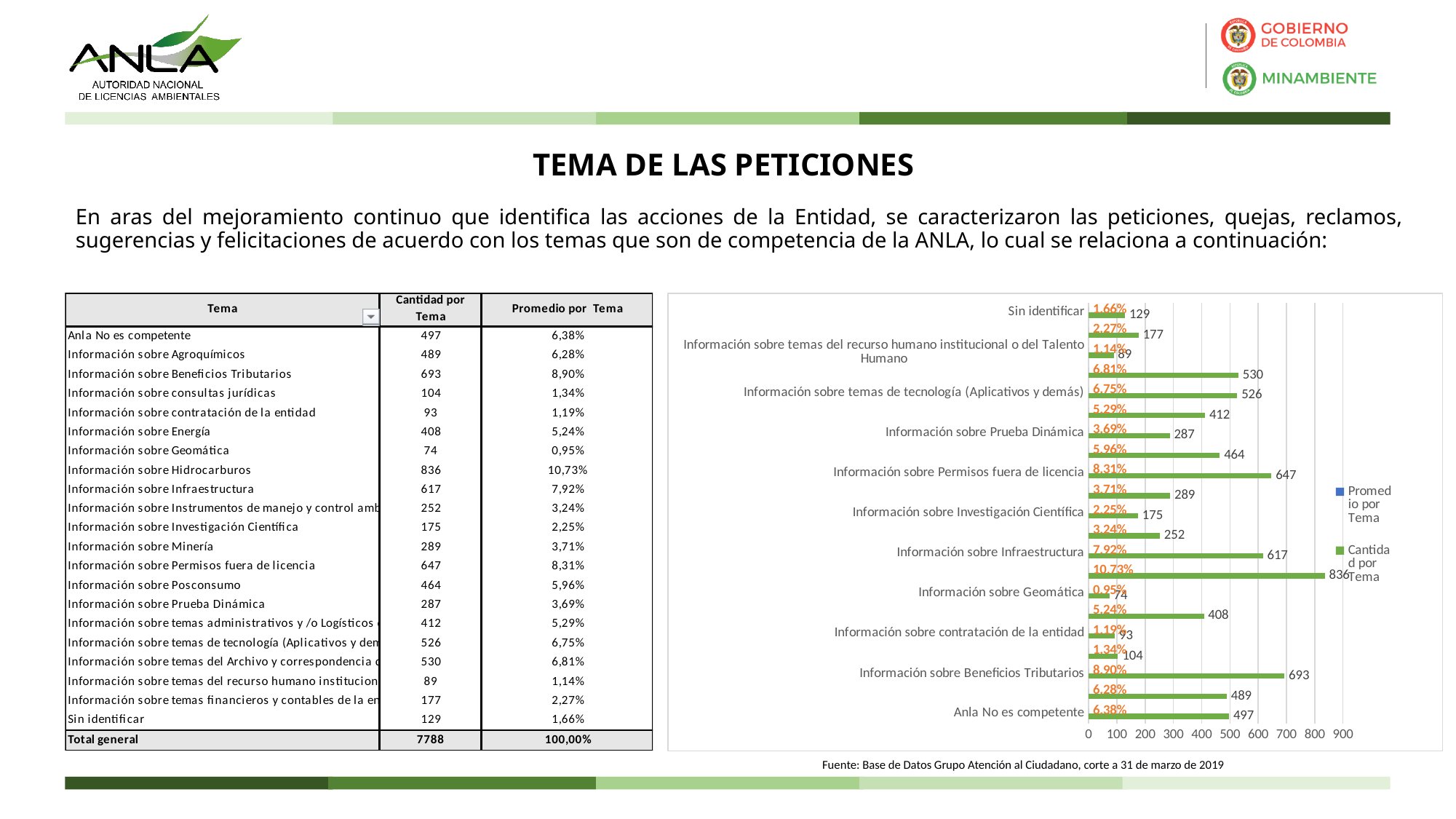
What is the Cantidad por Tema value for Información sobre Beneficios Tributarios in the chart? 693 Which has a larger Cantidad por Tema: Información sobre Infraestructura or Información sobre Permisos fuera de licencia? Información sobre Permisos fuera de licencia What is the Cantidad por Tema value for Sin identificar in the chart? 129 What is the difference in Cantidad por Tema between Información sobre Beneficios Tributarios and Anla No es competente? 196 What kind of chart is shown on the slide? bar chart Is the Cantidad por Tema value for Información sobre Prueba Dinámica greater or less than 300? less How many series does the chart legend list? 2 What is the Promedio por Tema value for Información sobre Permisos fuera de licencia in the chart? 8,31% Which category has the lowest Cantidad por Tema in the chart? Información sobre Geomática What is the highest Cantidad por Tema value shown in the chart? 836 How many categories (temas) are plotted in the chart? 21 What is the Promedio por Tema value for Información sobre Geomática in the chart? 0,95%